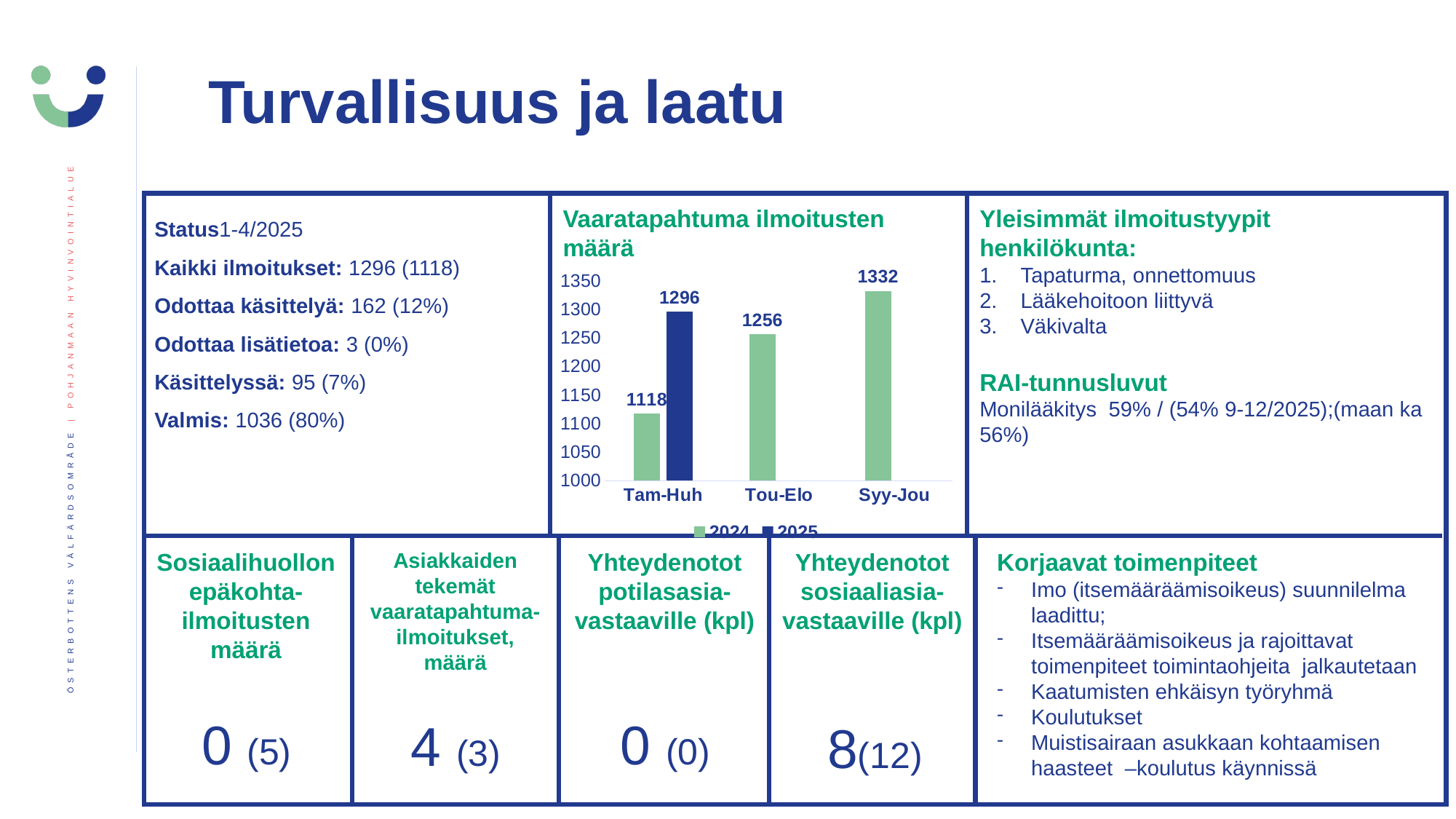
What type of chart is used to show Vaaratapahtuma ilmoitusten määrä? bar chart Do the 2024 values in the Vaaratapahtuma ilmoitusten määrä chart rise or fall from Tam-Huh to Syy-Jou? rise What is the 2024 value for Tam-Huh in the Vaaratapahtuma ilmoitusten määrä chart? 1118 How many periods are shown on the x axis of the Vaaratapahtuma ilmoitusten määrä chart? 3 What is the 2024 value for Syy-Jou in the Vaaratapahtuma ilmoitusten määrä chart? 1332 Which period has the lowest 2024 value in the Vaaratapahtuma ilmoitusten määrä chart? Tam-Huh What is the 2025 value for Tam-Huh in the Vaaratapahtuma ilmoitusten määrä chart? 1296 In the Vaaratapahtuma ilmoitusten määrä chart, which is larger for Tam-Huh: the 2024 value or the 2025 value? 2025 In the Vaaratapahtuma ilmoitusten määrä chart, what is the difference between the 2025 and 2024 values for Tam-Huh? 178 How many series does the legend of the Vaaratapahtuma ilmoitusten määrä chart list? 2 Which period has the highest 2024 value in the Vaaratapahtuma ilmoitusten määrä chart? Syy-Jou What is the 2024 value for Tou-Elo in the Vaaratapahtuma ilmoitusten määrä chart? 1256